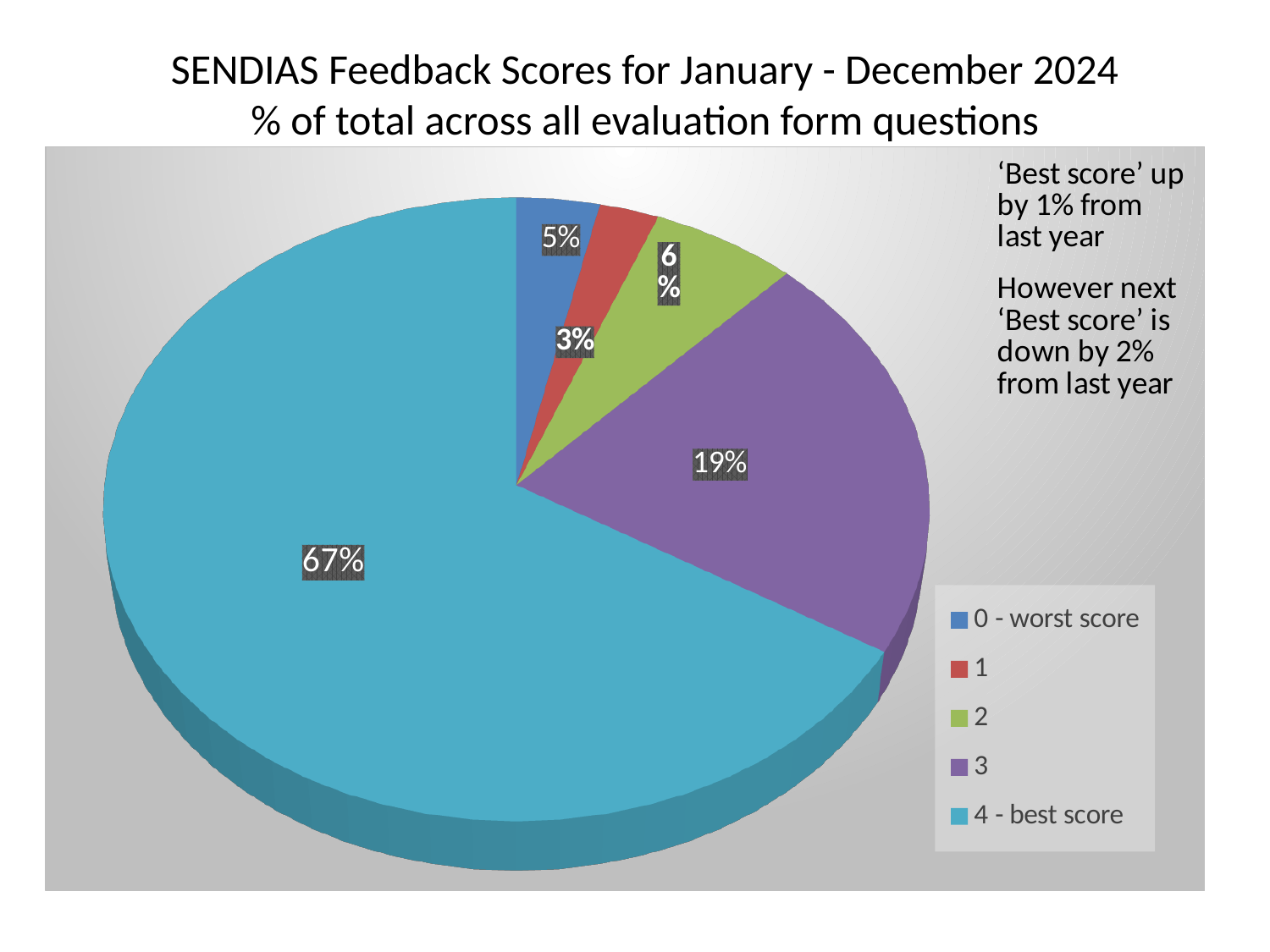
What is the title of the chart? SENDIAS Feedback Scores for January - December 2024 % of total across all evaluation form questions What is the difference in percentage points between the '4 - best score' slice and the '3' slice? 48 How many categories does the legend list? 5 What share of the pie does '4 - best score' take? 67% What share of the pie does '0 - worst score' take? 5% Which score category has the smallest slice of the pie? 1 What share of the pie does the score '1' take? 3% What kind of chart is shown on the slide? Pie chart Which slice is larger, '0 - worst score' or '2'? 2 Which score category has the largest slice of the pie? 4 - best score